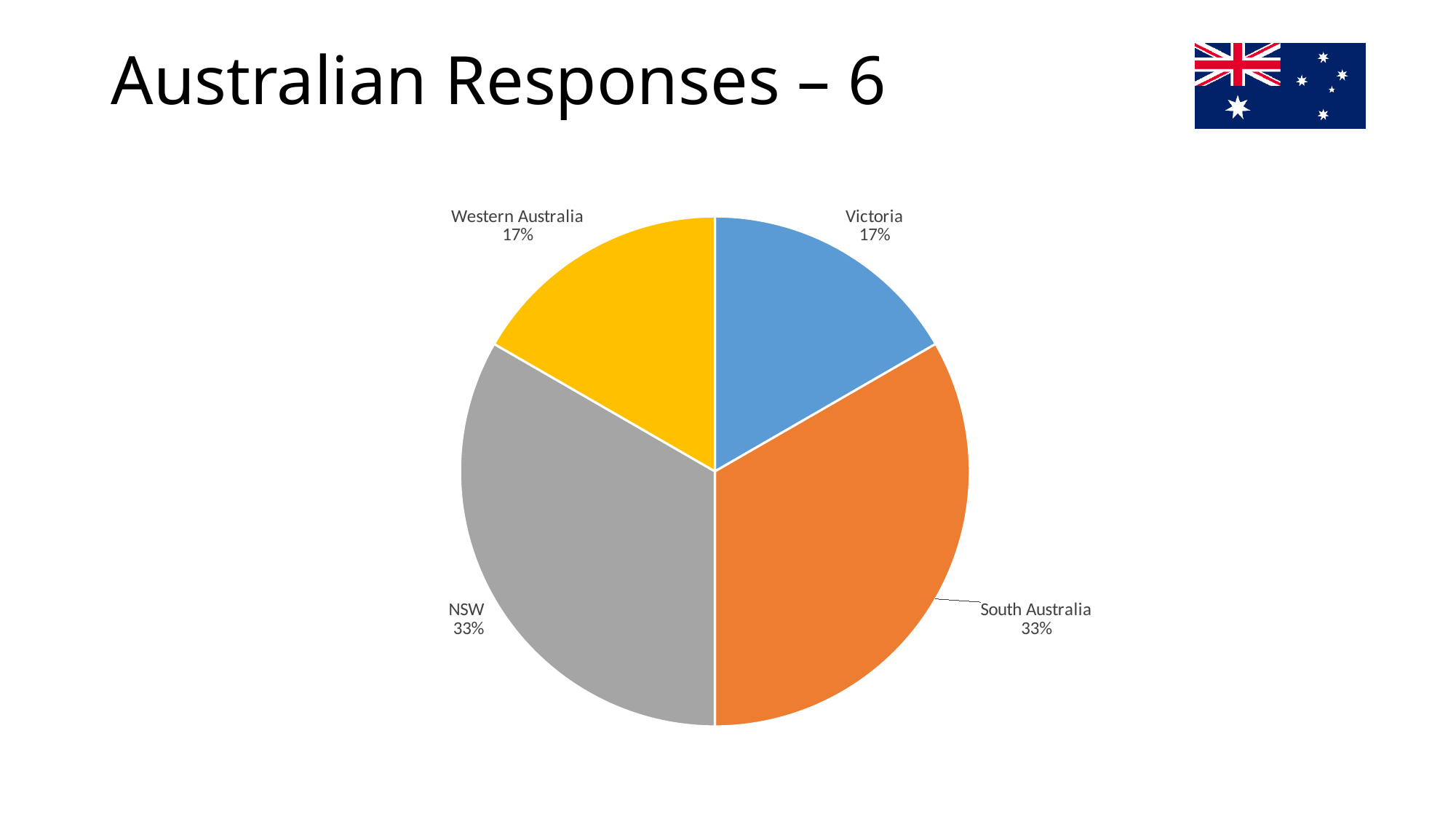
What is the difference in percentage points between the NSW share and the Victoria share? 16 What share of the pie does Victoria represent? 17% What colour is the Western Australia slice of the pie chart? yellow Which is larger, the share for South Australia or the share for Victoria? South Australia What share of the pie does South Australia represent? 33% What kind of chart is shown on the slide? pie chart What share of the pie does Western Australia represent? 17% What colour is the NSW slice of the pie chart? grey What is the difference in percentage points between the South Australia share and the Western Australia share? 16 Which is larger, the share for NSW or the share for Western Australia? NSW How many slices does the pie chart have? 4